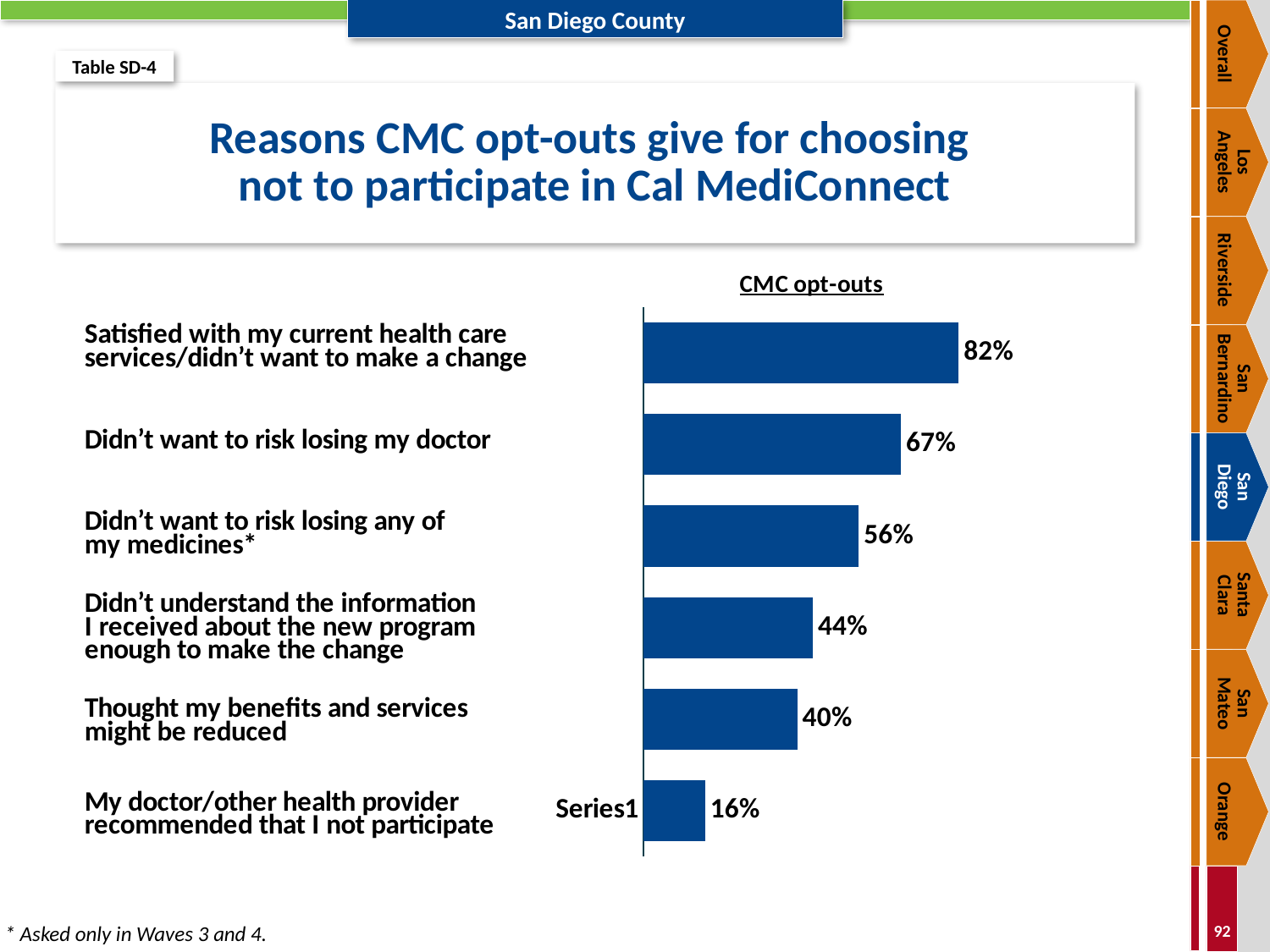
What type of chart is shown on the slide? Bar chart What percentage of CMC opt-outs said they didn't want to risk losing any of their medicines? 56% Which reason was given by the lowest percentage of CMC opt-outs? My doctor/other health provider recommended that I not participate What percentage of CMC opt-outs said their doctor/other health provider recommended that they not participate? 16% What is the table label shown in the top-left corner of the slide? Table SD-4 Which reason was cited more often: 'Didn't understand the information I received about the new program enough to make the change' or 'Thought my benefits and services might be reduced'? Didn't understand the information I received about the new program enough to make the change How many reasons are shown in the chart? 6 What percentage of CMC opt-outs said they didn't want to risk losing their doctor? 67% What is the heading shown above the bars in the chart? CMC opt-outs What percentage of CMC opt-outs said they were satisfied with their current health care services/didn't want to make a change? 82% What is the difference in percentage points between 'Didn't want to risk losing my doctor' and 'Thought my benefits and services might be reduced'? 27 Which reason was given by the highest percentage of CMC opt-outs? Satisfied with my current health care services/didn't want to make a change